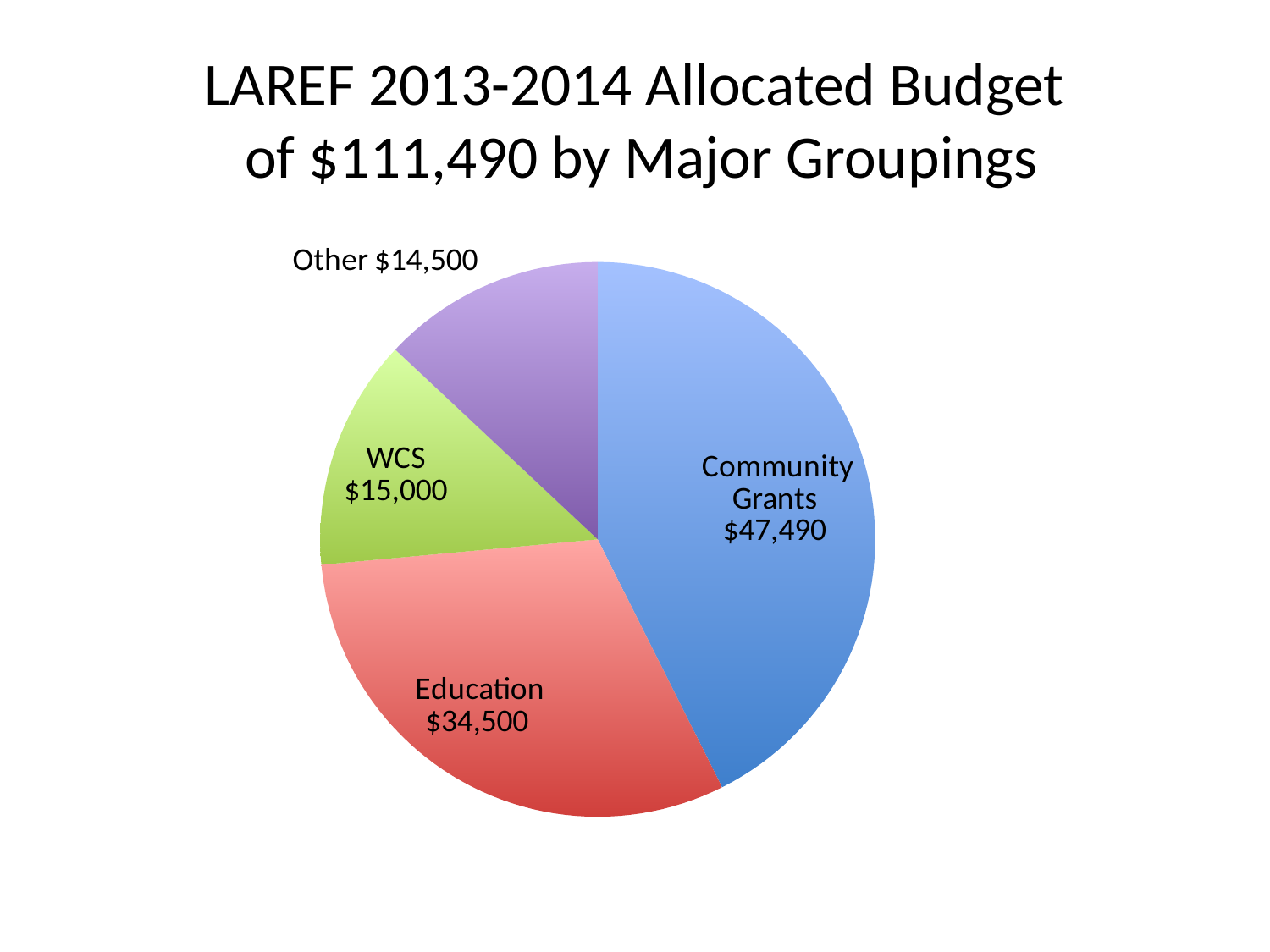
How much more is allocated to Community Grants than to Education? $12,990 Which grouping receives the largest share of the budget? Community Grants What is the allocated budget for WCS? $15,000 What is the allocated budget for Community Grants? $47,490 Which is larger, the Education allocation or the WCS allocation? Education What is the difference between the WCS and Other allocations? $500 What is the allocated budget for Education? $34,500 What is the allocated budget for Other? $14,500 How many groupings are shown in the pie chart? 4 Which grouping receives the smallest share of the budget? Other What kind of chart is shown on the slide? Pie chart What is the total budget shown in the chart title? $111,490